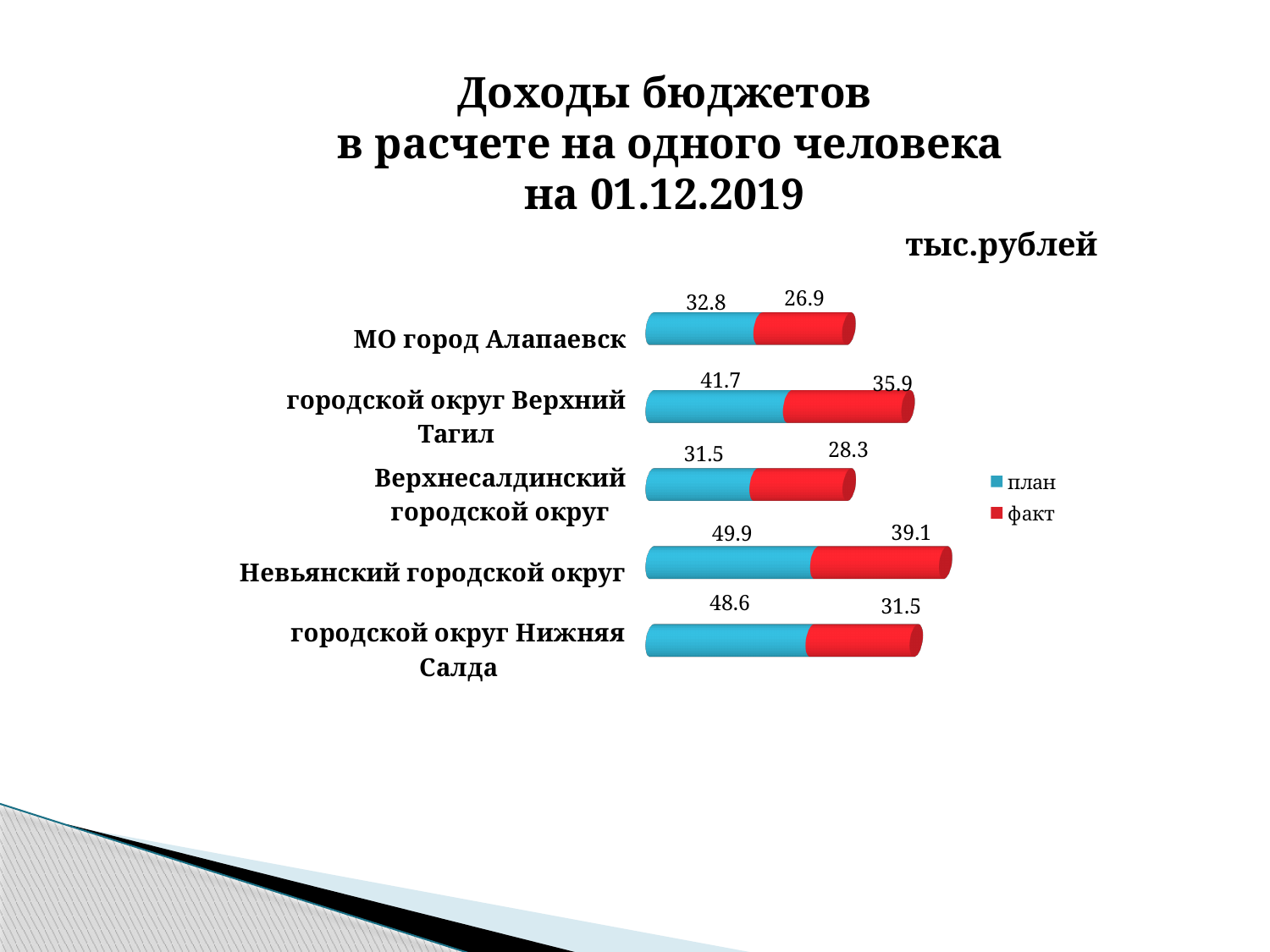
What is the факт value for городской округ Нижняя Салда? 31.5 What is the план value for Невьянский городской округ? 49.9 Which is larger: the факт value for городской округ Верхний Тагил or the факт value for Верхнесалдинский городской округ? городской округ Верхний Тагил What is the факт value for МО город Алапаевск? 26.9 Which category has the lowest факт value? МО город Алапаевск What unit is stated for the values in the chart? тыс.рублей How many categories (municipalities) are shown in the chart? 5 Which category has the highest план value? Невьянский городской округ What type of chart is shown on the slide? bar chart What is the total of the stacked bar for Невьянский городской округ (план plus факт)? 89.0 What is the difference between the план and факт values for городской округ Нижняя Салда? 17.1 How many series does the legend list? 2